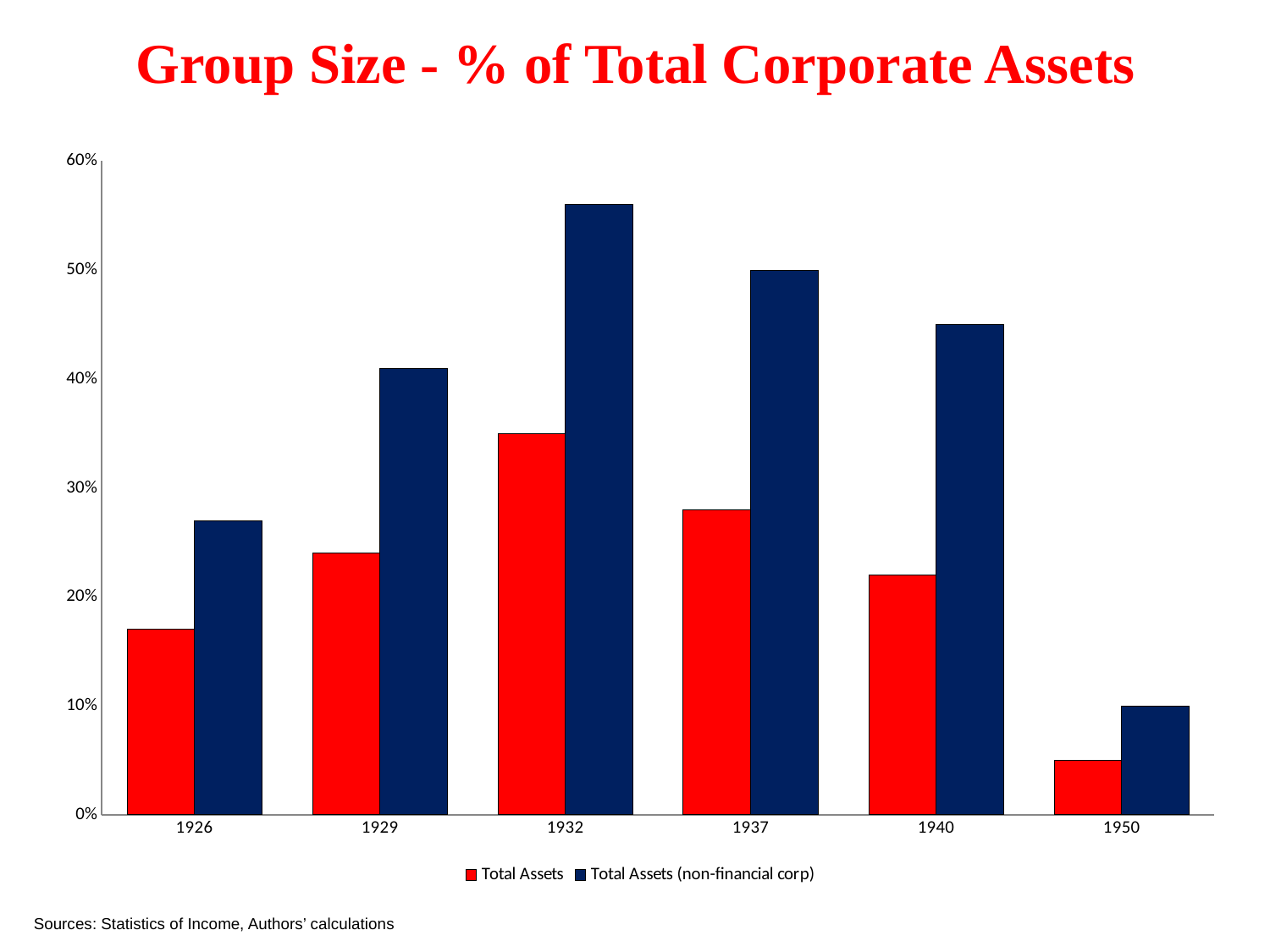
In which year is the Total Assets value lowest? 1950 Do the Total Assets values rise or fall from 1932 to 1950? Fall In which year is the Total Assets (non-financial corp) value highest? 1932 How many years are shown on the x axis of the chart? 6 In which year is the Total Assets value highest? 1932 What colour are the Total Assets (non-financial corp) bars? Dark blue In which year is the Total Assets (non-financial corp) value lowest? 1950 How many series does the legend list? 2 Is the Total Assets value for 1926 greater or less than 20%? less Which series has the larger value in 1929, Total Assets or Total Assets (non-financial corp)? Total Assets (non-financial corp) What kind of chart is shown on the slide? Bar chart